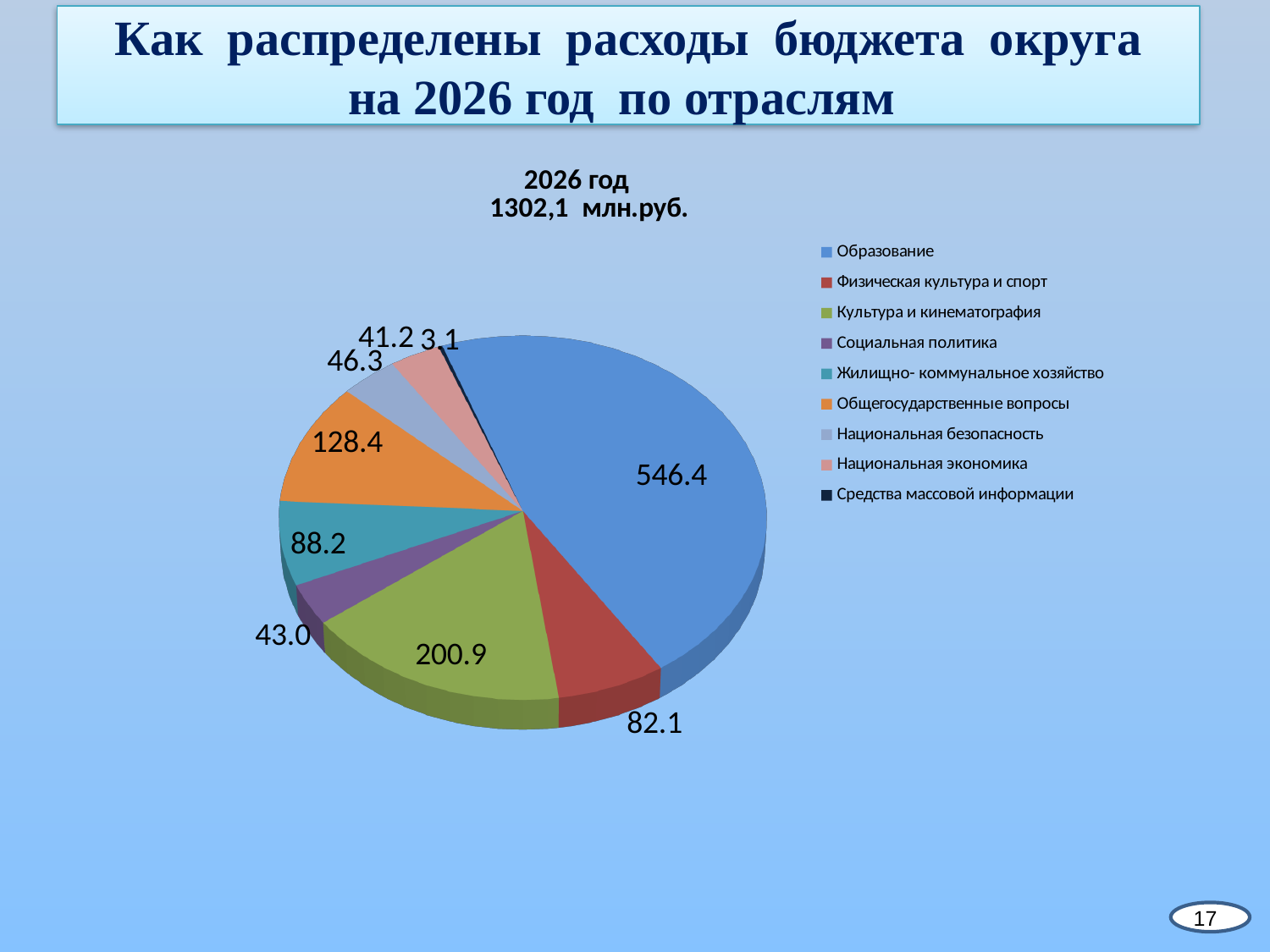
What is the value for Жилищно-коммунальное хозяйство? 88.2 How many categories does the pie chart show? 9 What is the value for Культура и кинематография? 200.9 What is the value for Общегосударственные вопросы? 128.4 Which category has the smallest slice of the pie? Средства массовой информации What is the value for Средства массовой информации? 3.1 What kind of chart is shown on the slide? pie chart What is the difference between the values for Образование and Культура и кинематография? 345.5 What total amount is stated in the chart title for 2026? 1302,1 млн.руб. Which is larger, the value for Физическая культура и спорт or the value for Социальная политика? Физическая культура и спорт What is the value for Образование? 546.4 Which category has the largest slice of the pie? Образование